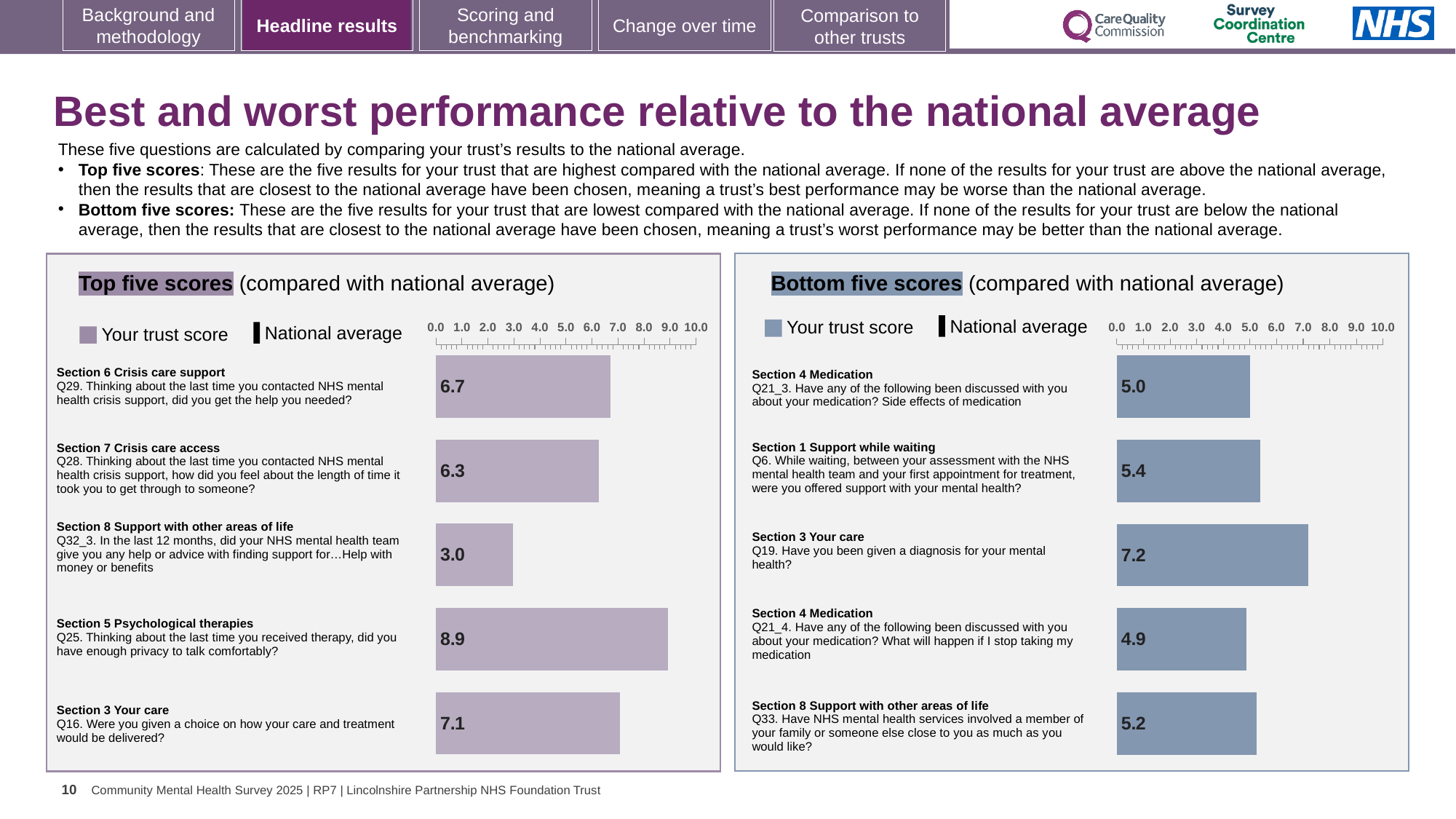
In the Bottom five scores chart, which has the larger trust score: Q6 or Q33? Q6 What type of chart is the Bottom five scores chart? Bar chart In the Top five scores chart, what is the difference between the trust scores for Q25 and Q32_3? 5.9 In the Top five scores chart, what is the trust score for Q25 (Section 5 Psychological therapies)? 8.9 In the Bottom five scores chart, which question has the highest trust score? Q19 (Section 3 Your care) In the Top five scores chart, what is the trust score for Q28 (Section 7 Crisis care access)? 6.3 In the Bottom five scores chart, what is the difference between the trust scores for Q19 and Q21_3? 2.2 In the Bottom five scores chart, which question has the lowest trust score? Q21_4 (Section 4 Medication) In the Top five scores chart, which question has the lowest trust score? Q32_3 (Section 8 Support with other areas of life) In the Bottom five scores chart, what is the trust score for Q19 (Section 3 Your care)? 7.2 How many bars are plotted in the Top five scores chart? 5 In the Top five scores chart, which question has the highest trust score? Q25 (Section 5 Psychological therapies)